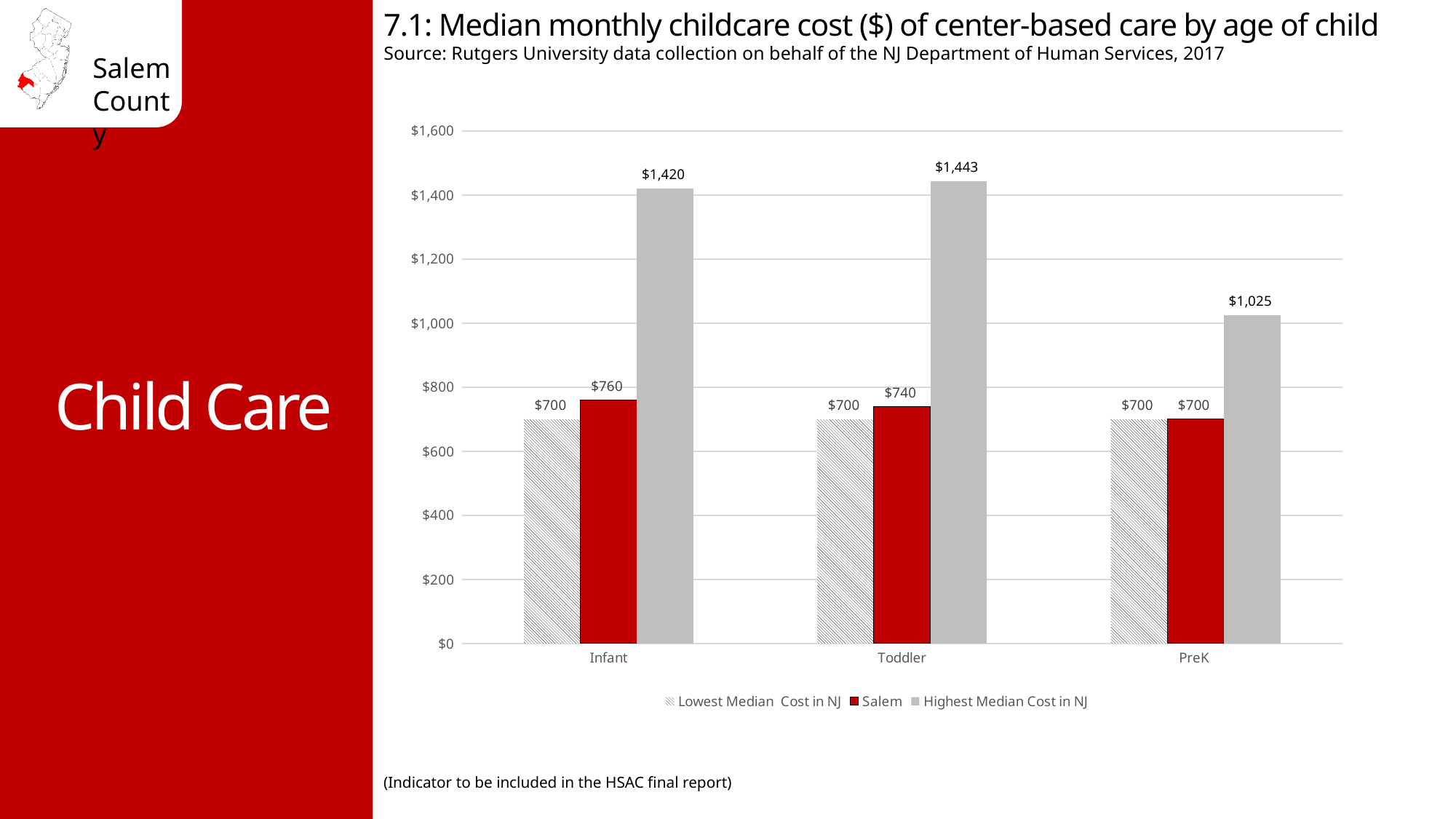
Is the Highest Median Cost in NJ for PreK greater or less than $1,200? less Which is larger for Toddler care: the Salem cost or the Lowest Median Cost in NJ? Salem What kind of chart is shown on the slide? bar chart What colour are the Salem bars? red What is the Salem median monthly childcare cost for Infant care? $760 What is the Highest Median Cost in NJ for Toddler care? $1,443 What is the Lowest Median Cost in NJ for PreK care? $700 Which age group has the lowest Salem median monthly cost? PreK What is the difference between the Highest Median Cost in NJ and the Salem cost for Infant care? $660 How many series does the legend list? 3 Which age group has the highest value for the Highest Median Cost in NJ series? Toddler How many age groups are shown on the x axis? 3